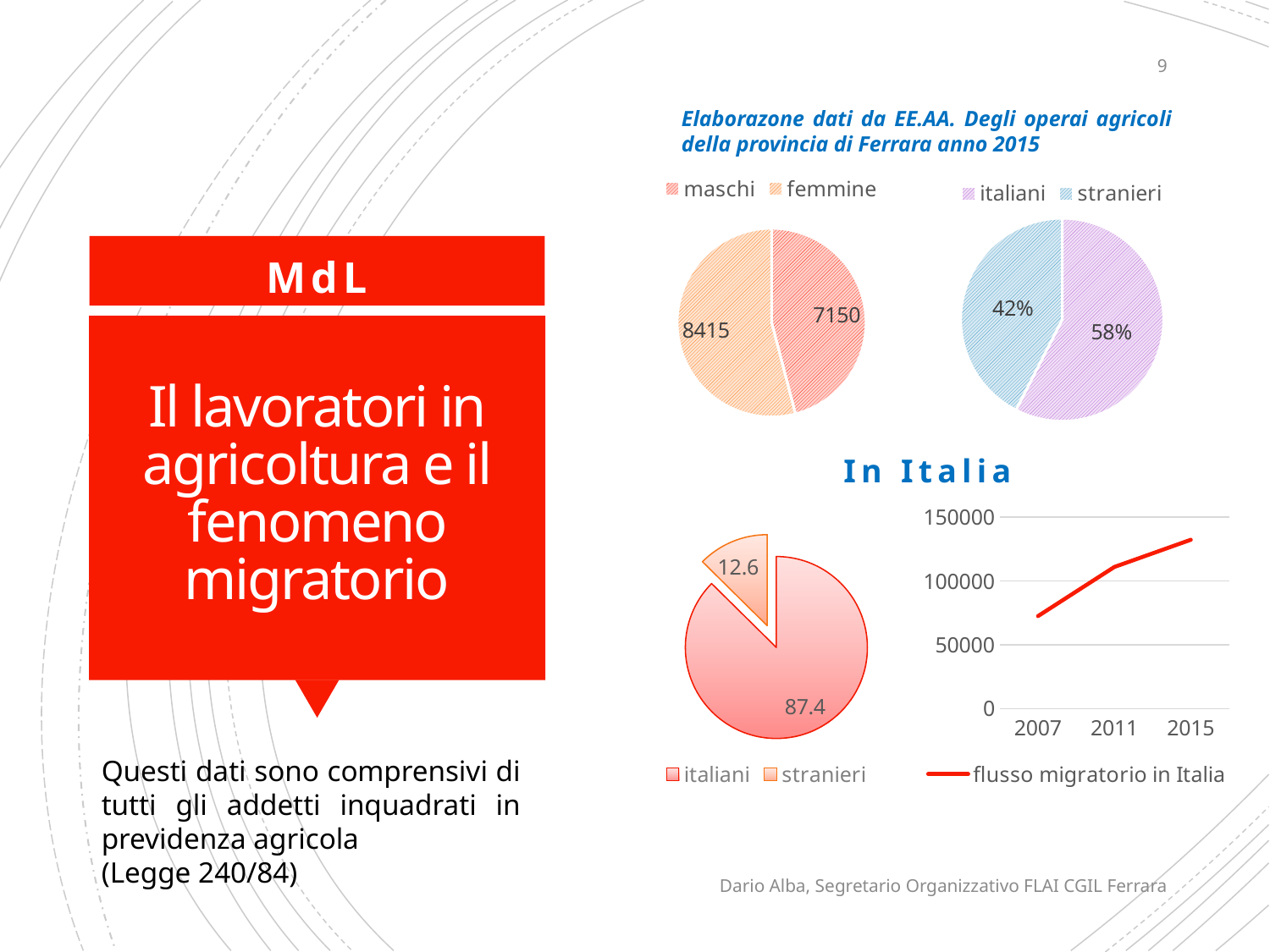
In the top-right pie chart (italiani/stranieri), what share is shown for italiani? 58% In the top-left pie chart (maschi/femmine), what is the value for femmine? 8415 In the bottom-right line chart, does the flusso migratorio in Italia rise or fall from 2007 to 2015? rise In the bottom-left pie chart under 'In Italia', what is the value for italiani? 87.4 In the bottom-right line chart, is the value for 2015 greater or less than 100000? greater In the top-right pie chart (italiani/stranieri), which slice is the largest? italiani What type of chart is the bottom-right chart showing flusso migratorio in Italia? line chart In the top-left pie chart (maschi/femmine), what is the value for maschi? 7150 In the top-left pie chart (maschi/femmine), what is the difference between the femmine and maschi values? 1265 In the top-left pie chart (maschi/femmine), which slice is larger, maschi or femmine? femmine In the top-right pie chart (italiani/stranieri), what share is shown for stranieri? 42% In the bottom-left pie chart under 'In Italia', what is the value for stranieri? 12.6